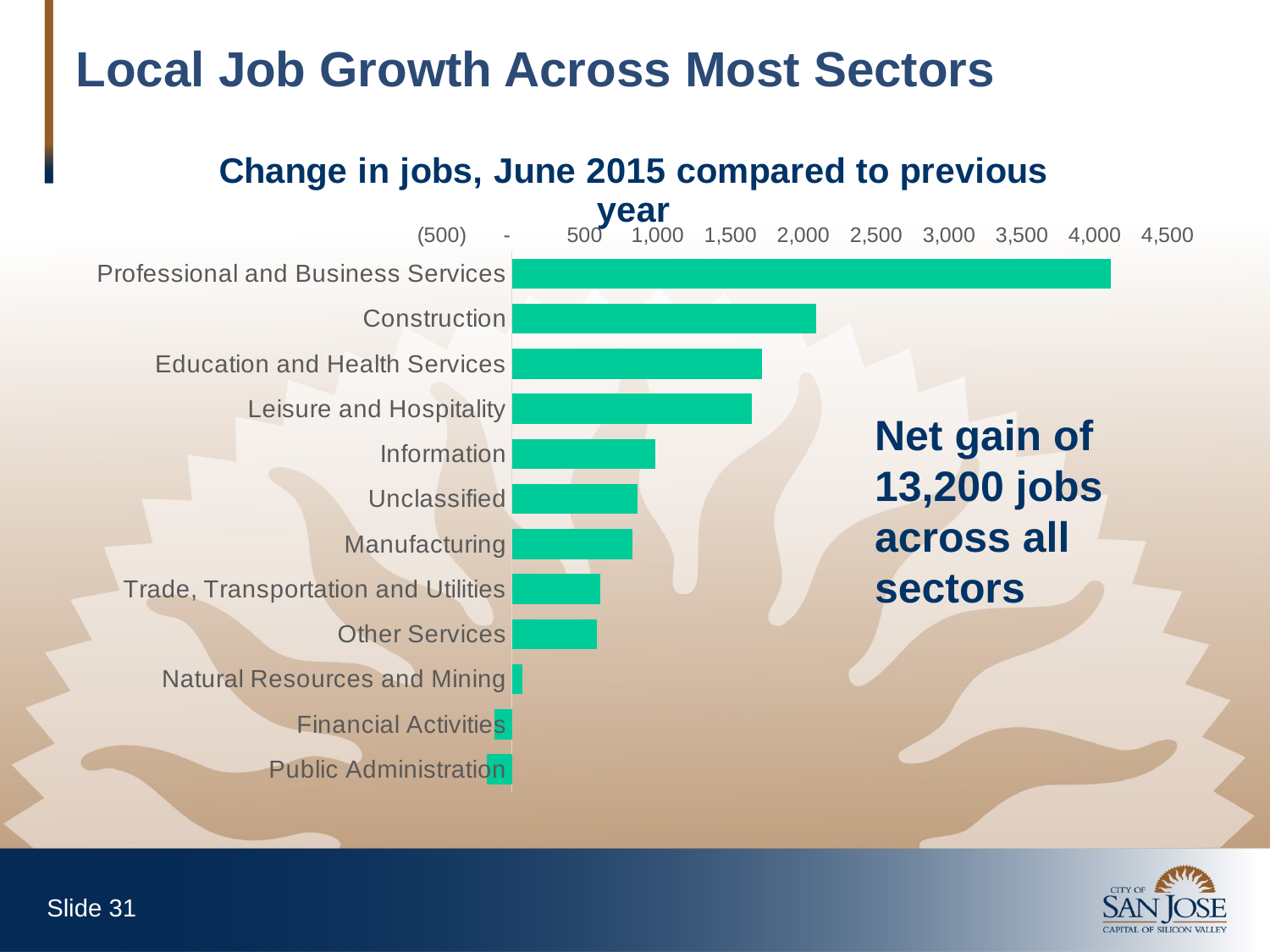
Which sector had a larger change in jobs, Construction or Education and Health Services? Construction Which sector shows the largest change in jobs? Professional and Business Services According to the text on the slide, what was the net gain in jobs across all sectors? 13,200 jobs Is the value for Education and Health Services greater or less than 2,000? less Is the value for Information greater or less than 500? greater How many sectors are plotted in the chart? 12 Is the value for Trade, Transportation and Utilities greater or less than 1,000? less How many sectors show a negative change in jobs? 2 What type of chart is shown on the slide? Bar chart